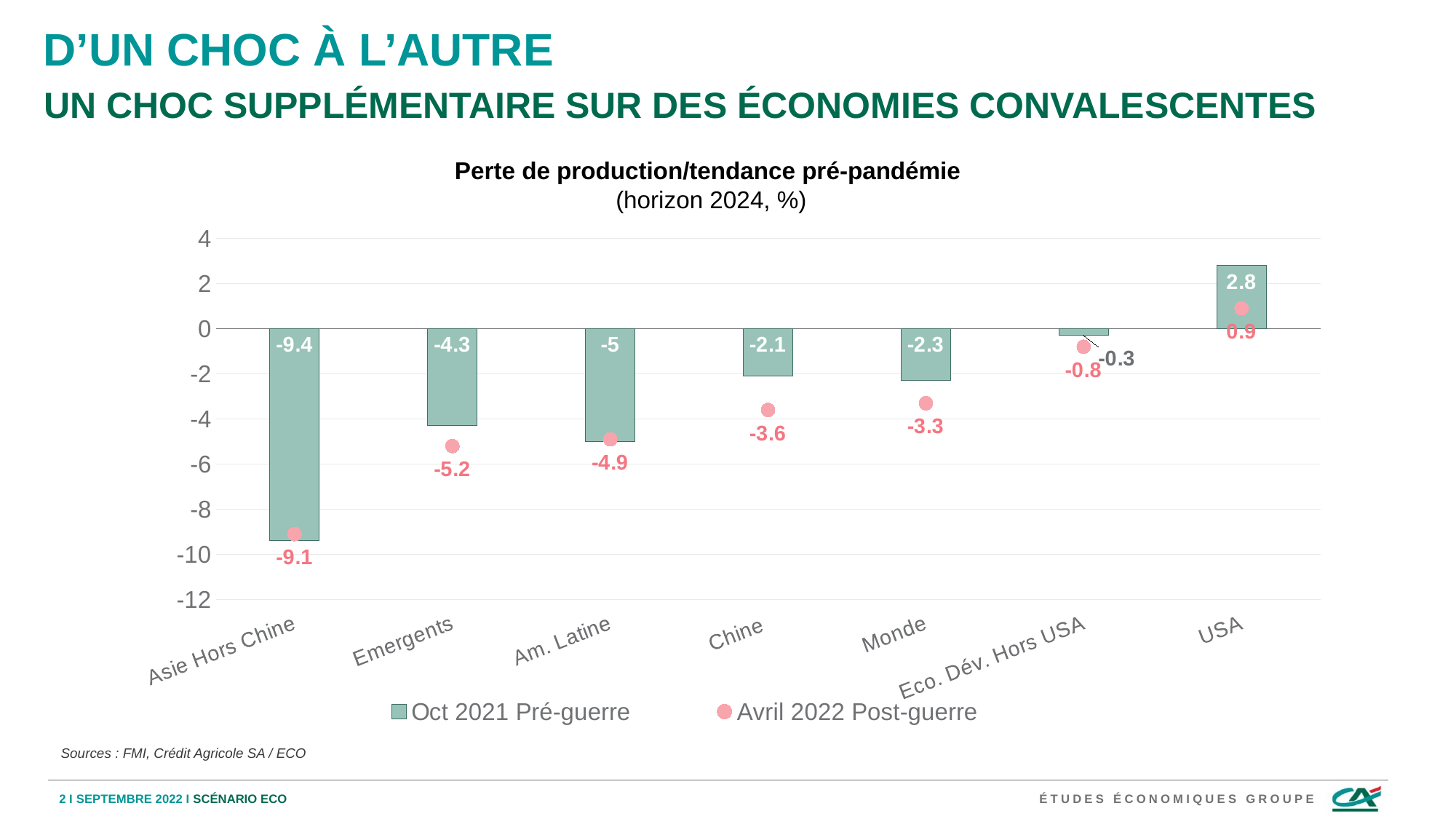
What is the Oct 2021 Pré-guerre value for USA? 2.8 What is the Avril 2022 Post-guerre value for Emergents? -5.2 Which category has the highest Avril 2022 Post-guerre value? USA How many series does the legend list? 2 How many categories are shown on the x axis? 7 What kind of chart is used for the Oct 2021 Pré-guerre series? Bar chart What is the difference between the Oct 2021 Pré-guerre and Avril 2022 Post-guerre values for Chine? 1.5 What is the title of the chart? Perte de production/tendance pré-pandémie (horizon 2024, %) Which category has the lowest Oct 2021 Pré-guerre value? Asie Hors Chine What is the Oct 2021 Pré-guerre value for Asie Hors Chine? -9.4 Which is larger for Monde: the Oct 2021 Pré-guerre value or the Avril 2022 Post-guerre value? Oct 2021 Pré-guerre What is the Avril 2022 Post-guerre value for Chine? -3.6